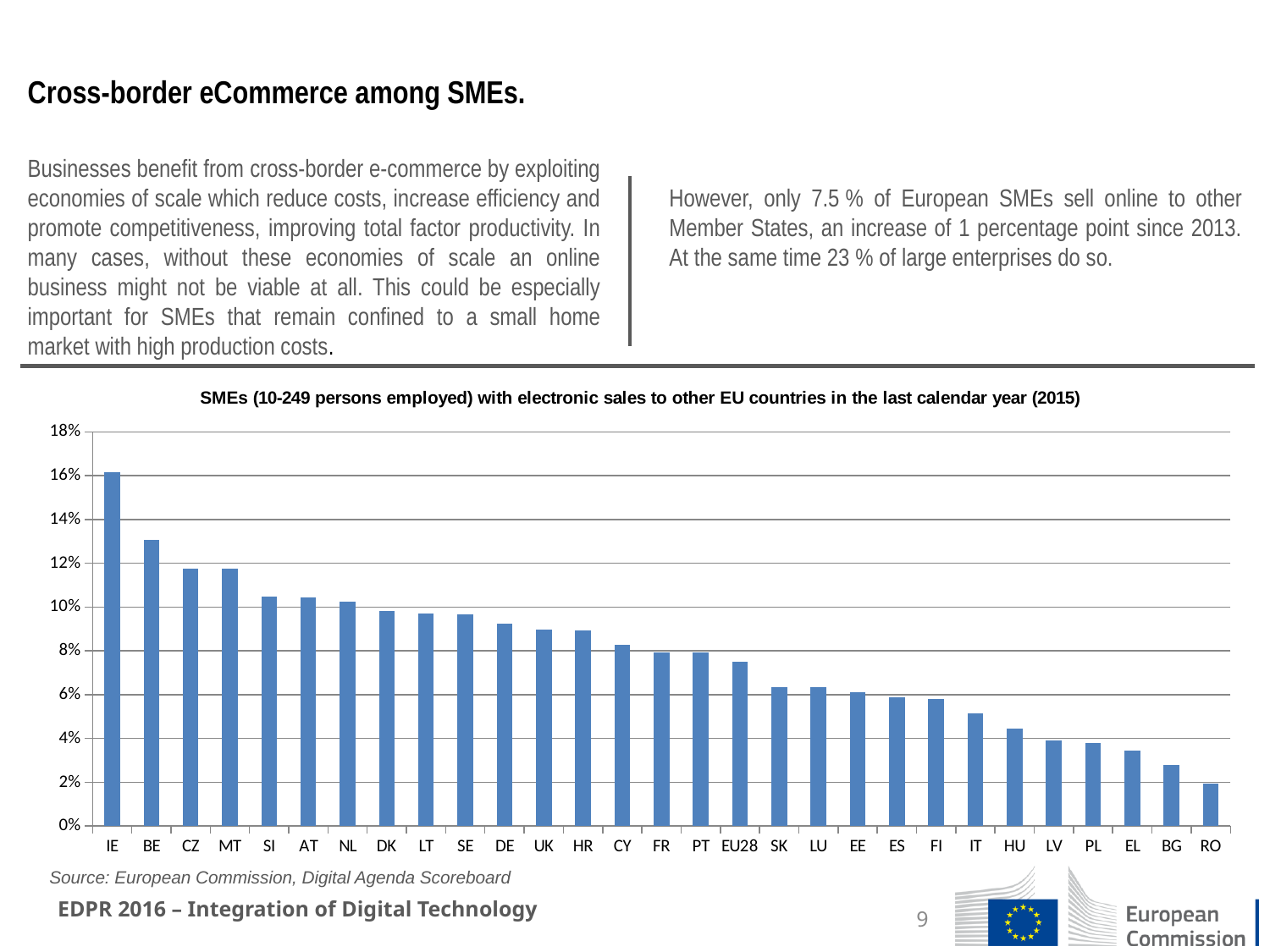
Which country has the highest share of SMEs with electronic sales to other EU countries? IE Is the value for BG greater or less than 4%? less Which has a larger value, EL or BG? EL Which country has the lowest share of SMEs with electronic sales to other EU countries? RO Is the value for EU28 greater or less than 8%? less What kind of chart is shown on the slide? bar chart Which has a larger value, IE or BE? IE Do the values rise or fall moving from left to right along the x axis? fall How many categories are shown on the x axis of the chart? 29 Is the value for BE greater or less than 12%? greater What is the title of the chart? SMEs (10-249 persons employed) with electronic sales to other EU countries in the last calendar year (2015)